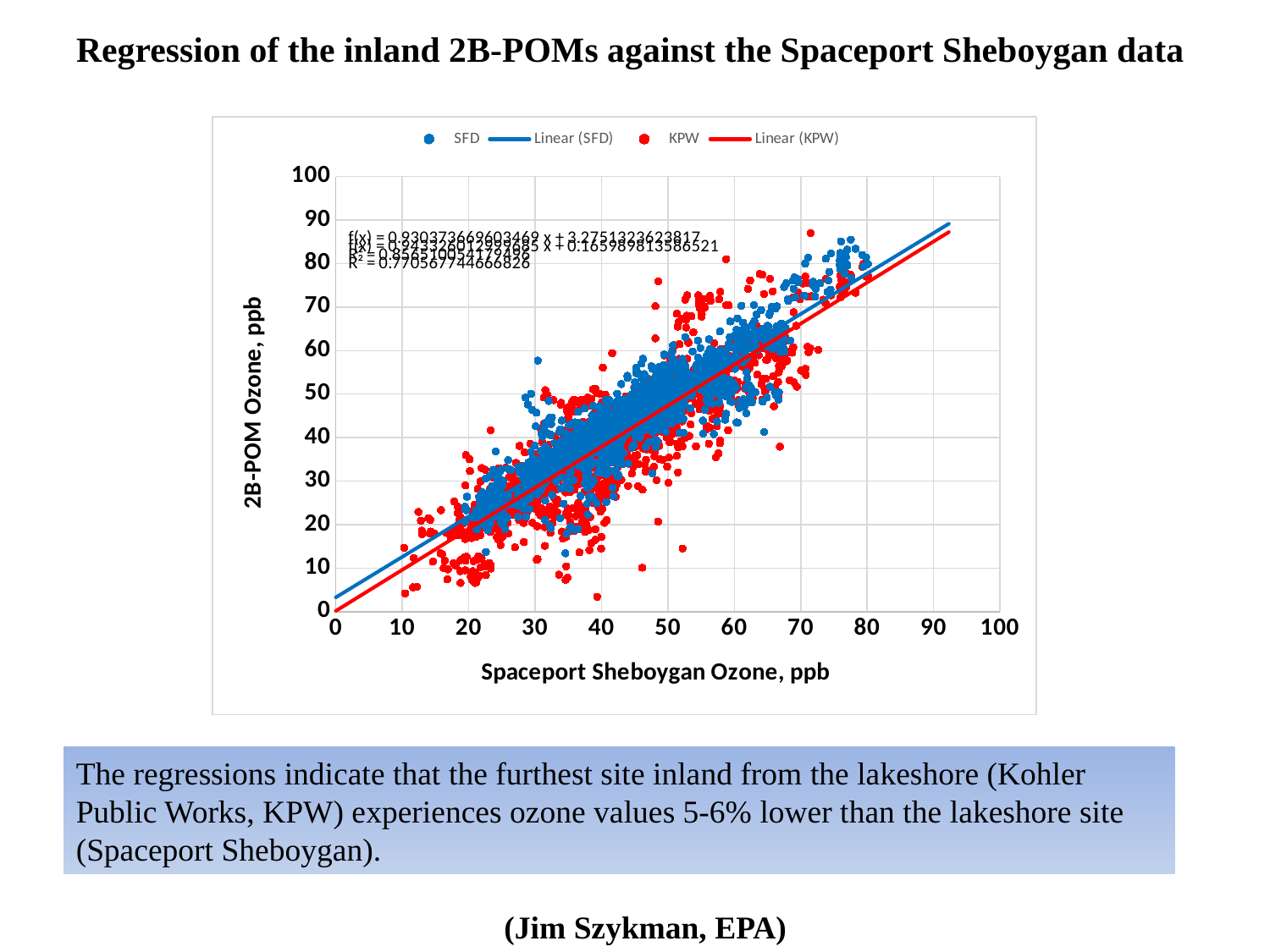
What is the label of the y axis? 2B-POM Ozone, ppb Which series is plotted in blue? SFD Do the plotted 2B-POM ozone values generally rise or fall as Spaceport Sheboygan ozone increases? Rise How many entries does the chart legend list? 4 What kind of chart is shown on the slide? Scatter chart What is the interval between consecutive tick marks on the y axis? 10 What is the maximum value shown on the y axis? 100 What is the title of the chart on the slide? Regression of the inland 2B-POMs against the Spaceport Sheboygan data What is the label of the x axis? Spaceport Sheboygan Ozone, ppb Which colour represents the KPW series? Red What is the maximum value shown on the x axis? 100